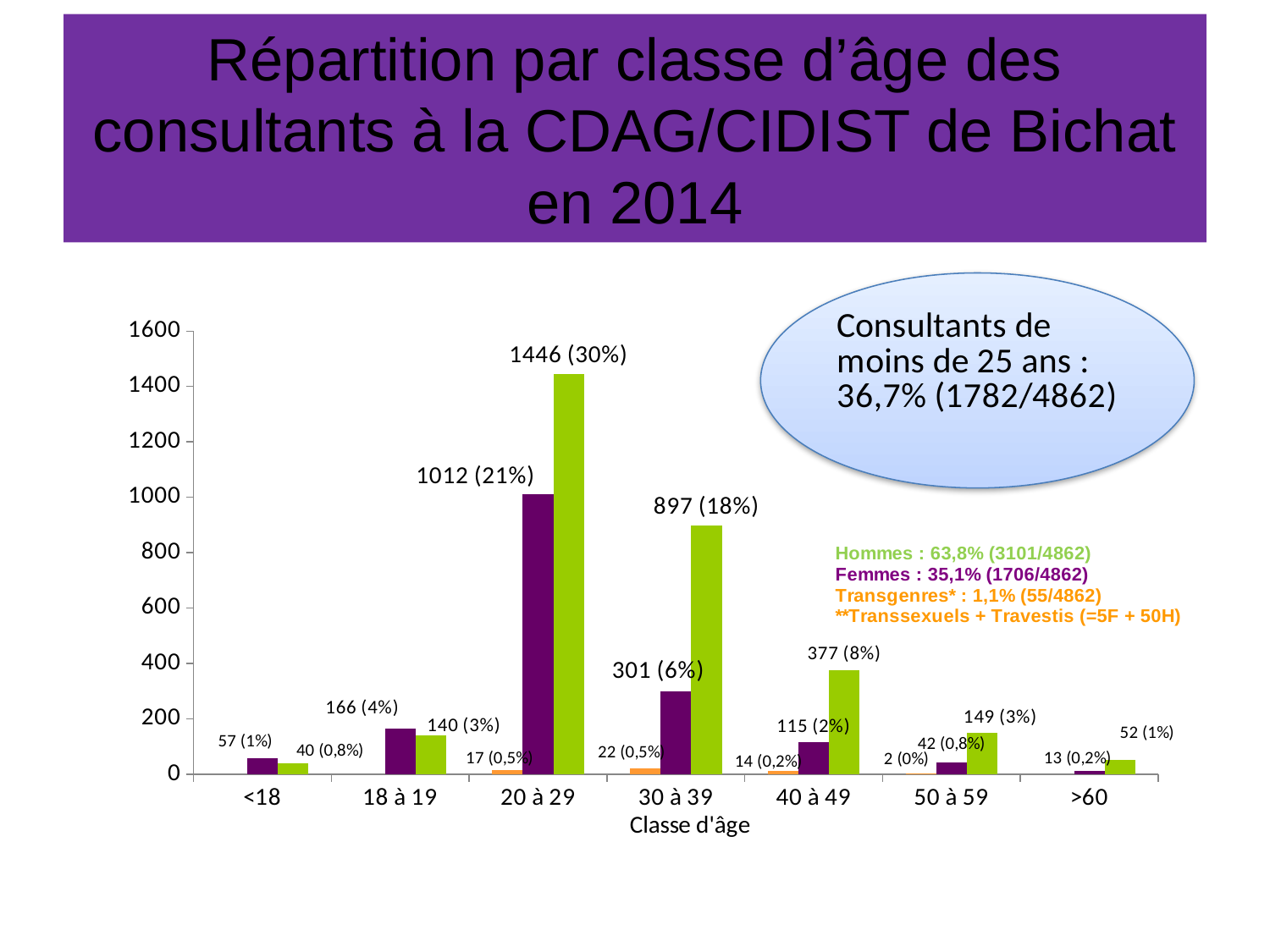
Do the Hommes (green) values rise or fall across the age classes from 20 à 29 to >60? Fall What is the title of the x axis of the chart? Classe d'âge In the 18 à 19 age class, which is larger: the Femmes value or the Hommes value? Femmes What is the data label for the Hommes (green) bar in the 20 à 29 age class? 1446 (30%) How many age classes are shown on the x axis of the chart? 7 Which age class has the highest Hommes (green) value? 20 à 29 Which age class has the lowest Hommes (green) value? <18 What kind of chart is shown on the slide? Bar chart What is the data label for the Transgenres (orange) bar in the 40 à 49 age class? 14 (0,2%) According to the callout on the slide, what share of consultants are under 25 years old? 36,7% (1782/4862) In the 20 à 29 age class, what is the difference between the Hommes count (1446) and the Femmes count (1012)? 434 What is the data label for the Femmes (purple) bar in the 30 à 39 age class? 301 (6%)